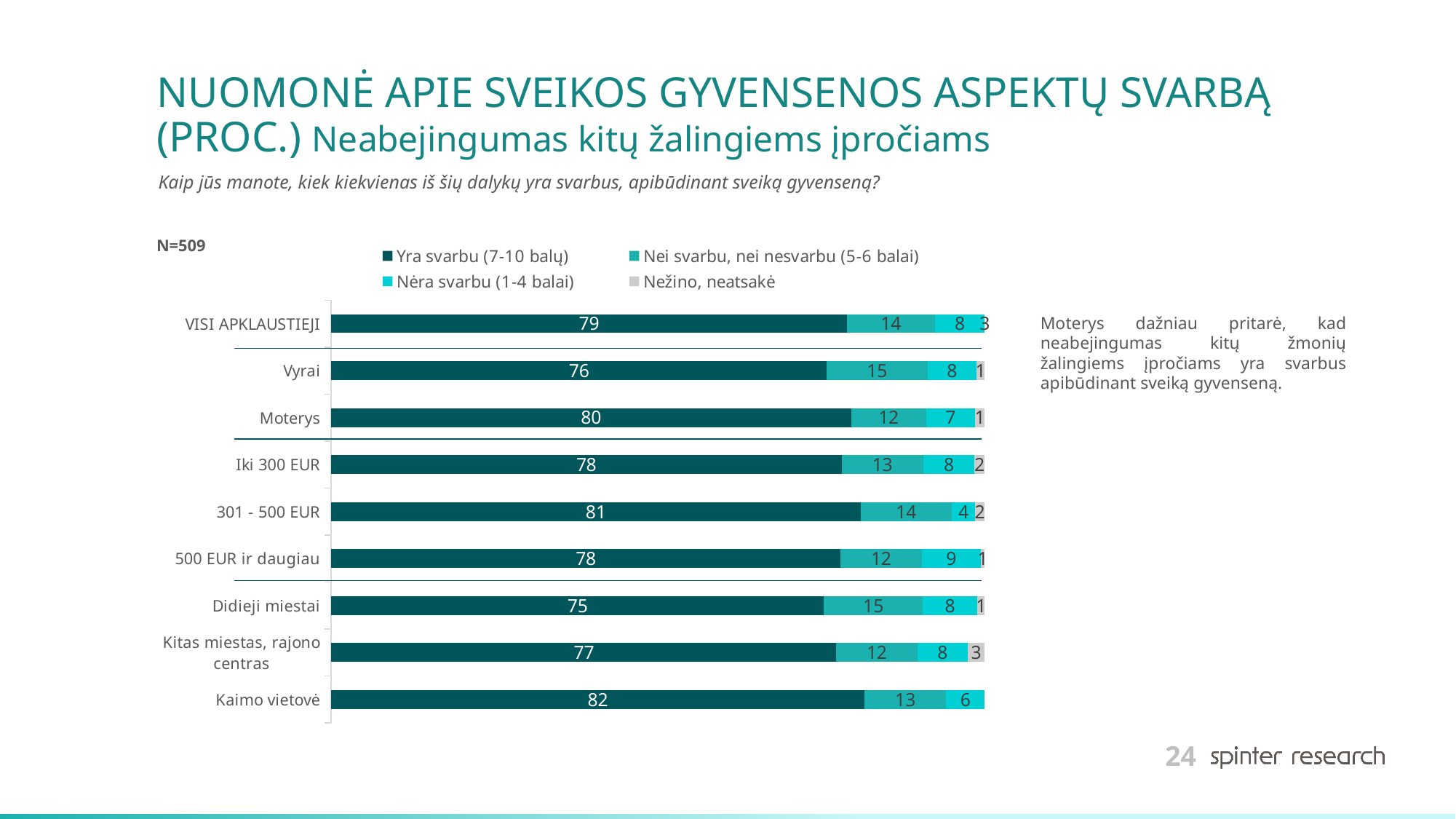
What kind of chart is shown on the slide? Stacked bar chart What is the value of "Nežino, neatsakė" for Kitas miestas, rajono centras? 3 Which category has the lowest value for "Yra svarbu (7-10 balų)"? Didieji miestai Which category has the highest value for "Yra svarbu (7-10 balų)"? Kaimo vietovė What is the value of "Yra svarbu (7-10 balų)" for Moterys? 80 Which has a larger "Yra svarbu (7-10 balų)" value: Iki 300 EUR or 301 - 500 EUR? 301 - 500 EUR What is the value of "Nėra svarbu (1-4 balai)" for 500 EUR ir daugiau? 9 How many series does the legend list? 4 What is the total of the stacked bar for Vyrai? 100 What is the difference between the "Yra svarbu (7-10 balų)" values for Moterys and Vyrai? 4 How many categories are shown on the chart? 9 What is the value of "Nei svarbu, nei nesvarbu (5-6 balai)" for Vyrai? 15